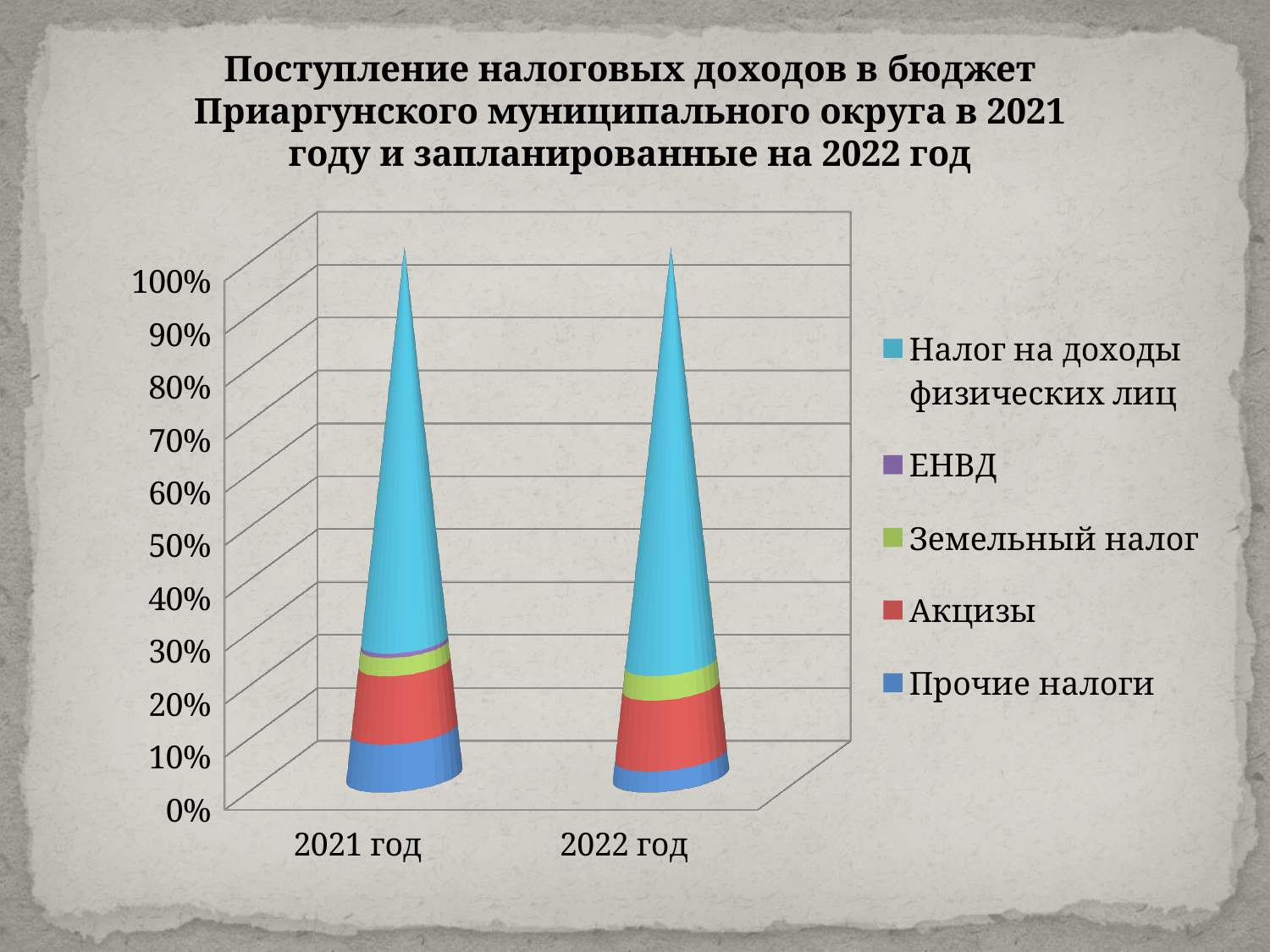
Which series is shown in red in the legend? Акцизы Which series has the largest share in the 2021 год bar? Налог на доходы физических лиц Is the share of Налог на доходы физических лиц larger in 2021 год or in 2022 год? 2022 год How many series does the legend list? 5 Which series has the largest share in the 2022 год bar? Налог на доходы физических лиц What is the title of the chart? Поступление налоговых доходов в бюджет Приаргунского муниципального округа в 2021 году и запланированные на 2022 год Is the share of Прочие налоги in 2021 год greater or less than 20%? less How many categories are shown on the x axis of the chart? 2 Is the share of Прочие налоги larger in 2021 год or in 2022 год? 2021 год What kind of chart is shown on the slide? Stacked bar chart Is the share of Налог на доходы физических лиц in 2021 год greater or less than 50%? greater Is the share of Прочие налоги in 2022 год greater or less than 10%? less